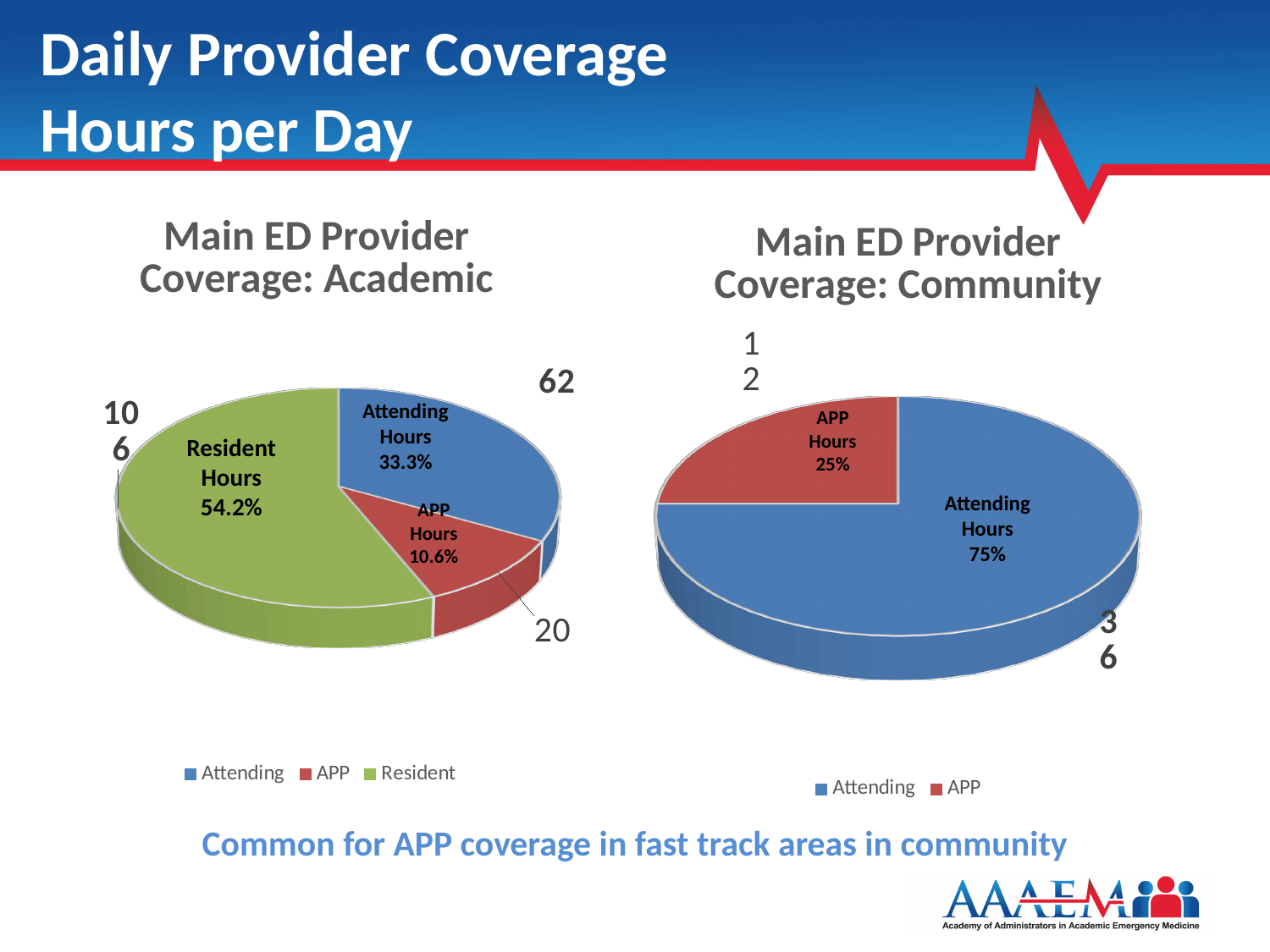
In the 'Main ED Provider Coverage: Academic' chart, which category has the largest share? Resident How many categories does the legend of the 'Main ED Provider Coverage: Academic' chart list? 3 What kind of chart is the 'Main ED Provider Coverage: Academic' chart? pie chart In the 'Main ED Provider Coverage: Academic' chart, which category has the smallest share? APP In the 'Main ED Provider Coverage: Academic' chart, what percentage is Attending Hours? 33.3% In the 'Main ED Provider Coverage: Community' chart, what percentage is APP Hours? 25% In the 'Main ED Provider Coverage: Academic' chart, what is the value labelled for the APP slice? 20 In the 'Main ED Provider Coverage: Academic' chart, what percentage is Resident Hours? 54.2% In the 'Main ED Provider Coverage: Academic' chart, what percentage is APP Hours? 10.6% How many categories does the legend of the 'Main ED Provider Coverage: Community' chart list? 2 In the 'Main ED Provider Coverage: Academic' chart, what is the value labelled for the Attending slice? 62 In the 'Main ED Provider Coverage: Community' chart, what percentage is Attending Hours? 75%